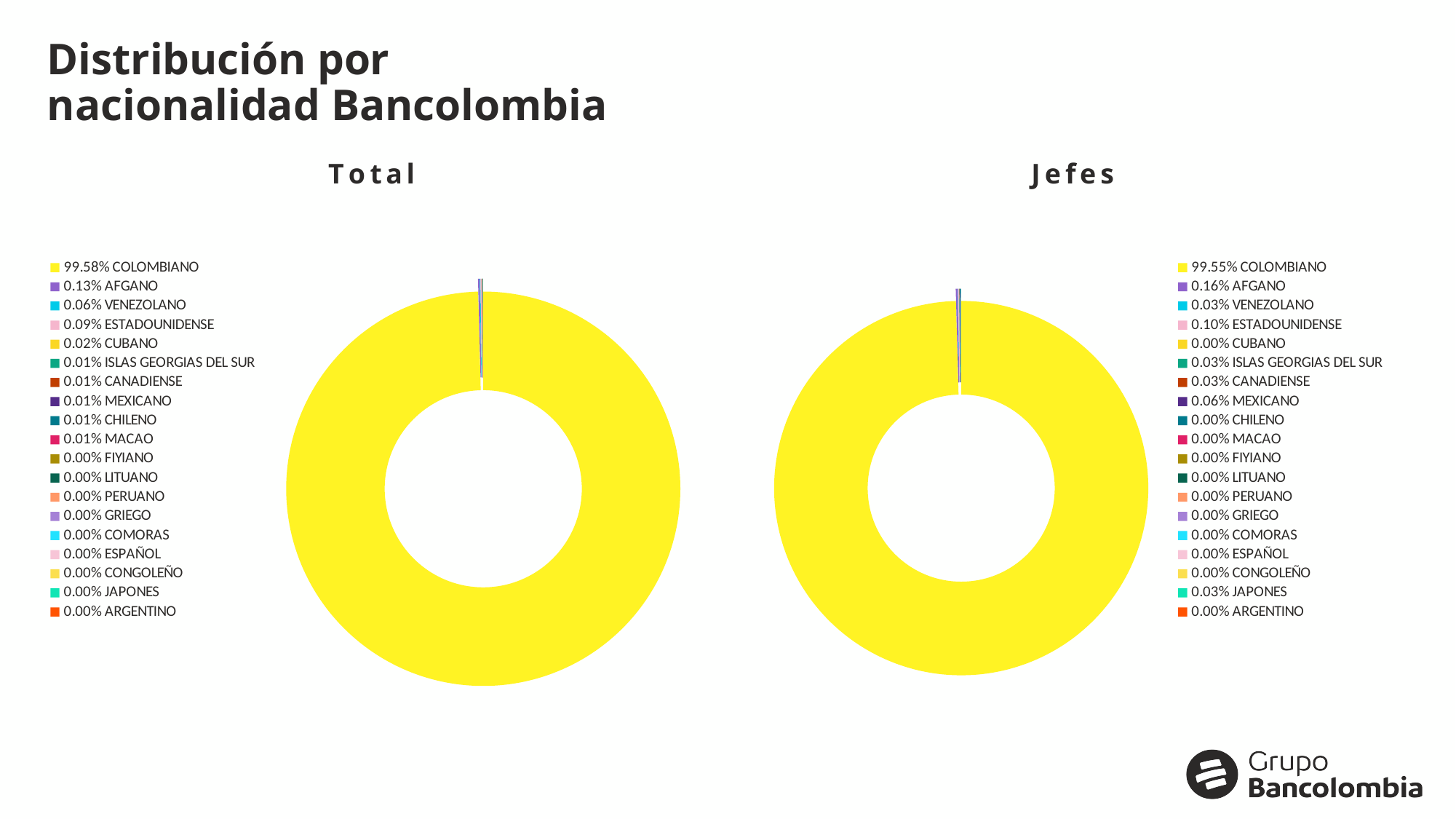
In the Total chart, which nationality has the largest share? COLOMBIANO In the Total chart, what share is COLOMBIANO? 99.58% In the Total chart, what is the difference between the AFGANO share and the VENEZOLANO share? 0.07% In the Total chart, what share is AFGANO? 0.13% In the Jefes chart, what share is ESTADOUNIDENSE? 0.10% In the Jefes chart, what share is MEXICANO? 0.06% In the Jefes chart, which nationality has the largest share? COLOMBIANO How many nationality categories does the legend of the Total chart list? 19 In the Jefes chart, which is larger, the share for AFGANO or the share for ESTADOUNIDENSE? AFGANO In the Jefes chart, what share is COLOMBIANO? 99.55% What kind of chart is the Total chart? Pie (donut) chart What is the title of the slide? Distribución por nacionalidad Bancolombia